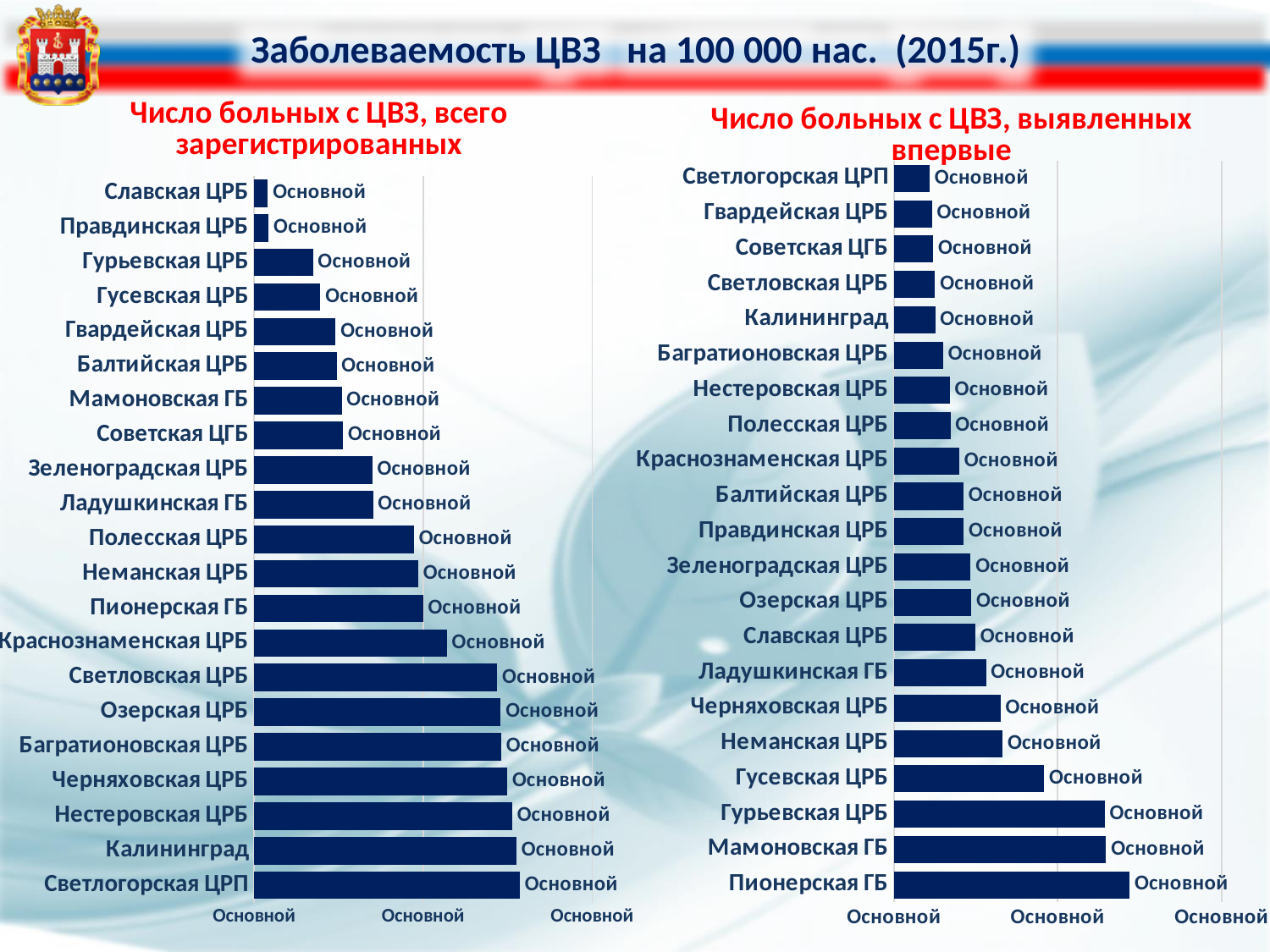
In the left chart, 'Число больных с ЦВЗ, всего зарегистрированных', which has the larger value: Краснознаменская ЦРБ or Гурьевская ЦРБ? Краснознаменская ЦРБ In the right chart, 'Число больных с ЦВЗ, выявленных впервые', which has the larger value: Гурьевская ЦРБ or Калининград? Гурьевская ЦРБ What colour are the bars in both charts? Dark blue In the left chart, 'Число больных с ЦВЗ, всего зарегистрированных', which category has the longest bar? Светлогорская ЦРП What is the title of the slide containing the two charts? Заболеваемость ЦВЗ на 100 000 нас. (2015г.) How many categories are plotted in the right chart, 'Число больных с ЦВЗ, выявленных впервые'? 21 How many categories are plotted in the left chart, 'Число больных с ЦВЗ, всего зарегистрированных'? 21 What kind of chart is the left chart, 'Число больных с ЦВЗ, всего зарегистрированных'? Bar chart In the right chart, 'Число больных с ЦВЗ, выявленных впервые', which has the larger value: Мамоновская ГБ or Светловская ЦРБ? Мамоновская ГБ In the right chart, 'Число больных с ЦВЗ, выявленных впервые', which category has the longest bar? Пионерская ГБ What kind of chart is the right chart, 'Число больных с ЦВЗ, выявленных впервые'? Bar chart